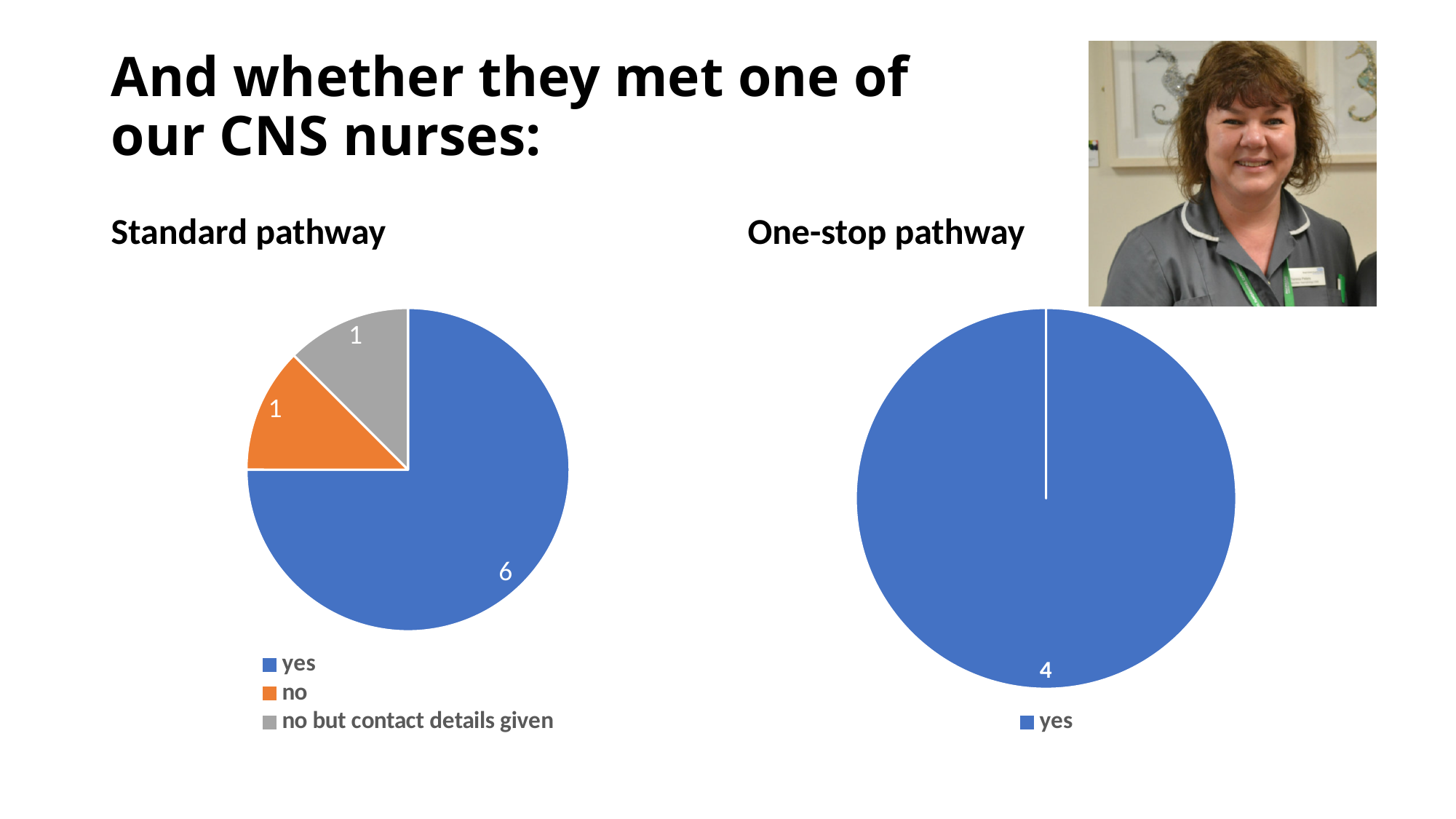
What kind of chart is the Standard pathway chart? pie chart In the Standard pathway chart, what is the difference between the values for "yes" and "no"? 5 In the One-stop pathway chart, what is the value for "yes"? 4 How many entries does the legend of the One-stop pathway chart list? 1 In the Standard pathway chart, what is the value for "no but contact details given"? 1 In the Standard pathway chart, what is the value for "no"? 1 In the Standard pathway chart, what colour is the "no" slice? orange In the Standard pathway chart, which category has the highest value? yes In the Standard pathway chart, which is larger, the value for "yes" or the value for "no"? yes In the Standard pathway chart, what is the value for "yes"? 6 In the Standard pathway chart, what share of the total does the "yes" slice represent? 75% How many categories does the Standard pathway chart show? 3